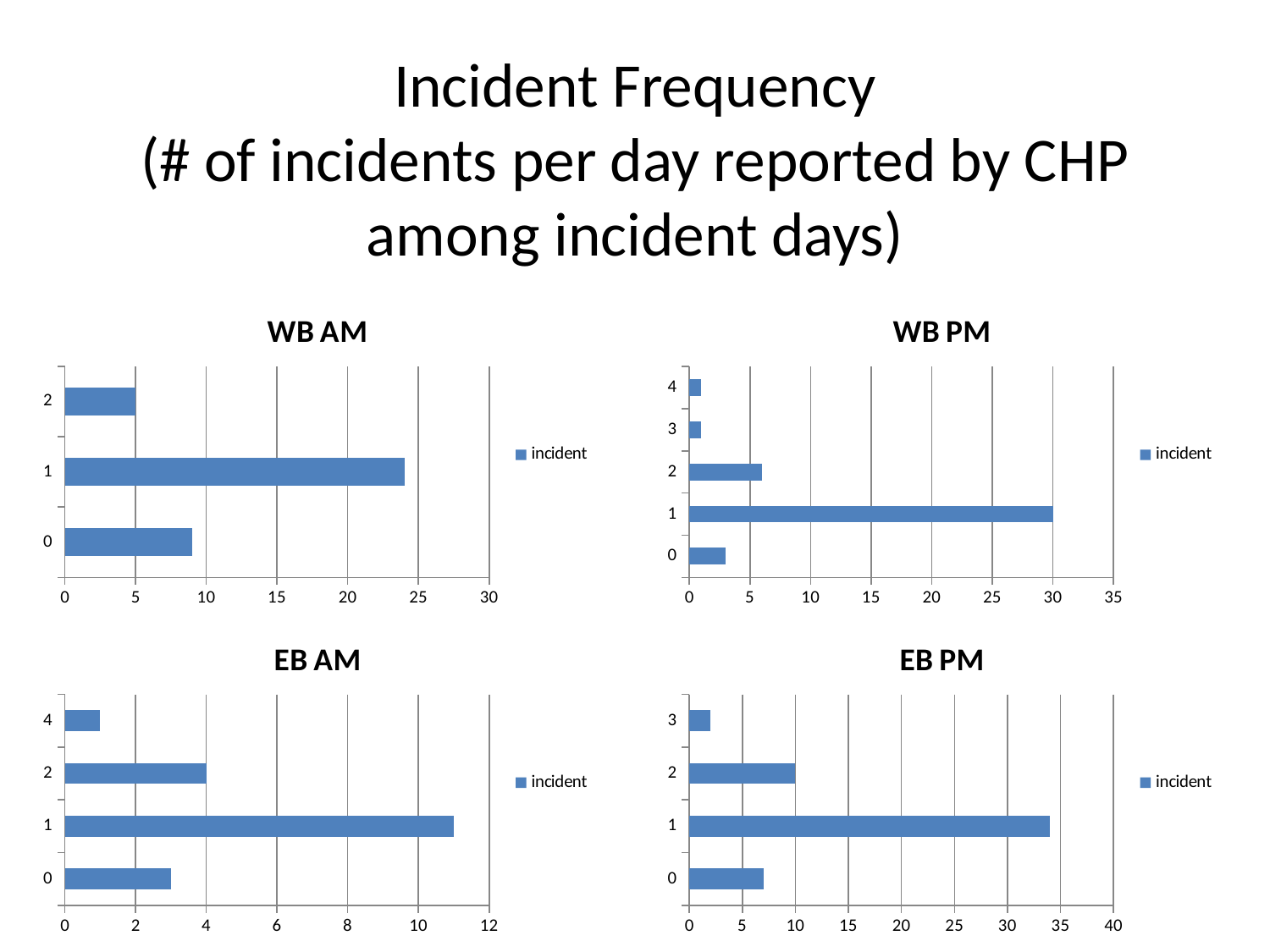
How many series does the legend of the EB AM chart list? 1 In the EB AM chart, which category has the shortest bar? 4 In the WB AM chart, what is the value for category 2? 5 In the WB AM chart, which category has the longest bar? 1 In the WB PM chart, how many categories are shown on the vertical axis? 5 In the EB AM chart, how many categories are shown on the vertical axis? 4 In the WB AM chart, is the value for category 1 greater or less than 20? greater What kind of chart is the WB AM chart? bar chart In the WB PM chart, what is the value for category 1? 30 In the EB PM chart, is the value for category 1 greater or less than 30? greater In the EB PM chart, which category has the longest bar? 1 In the EB PM chart, which has the larger value, category 0 or category 2? 2